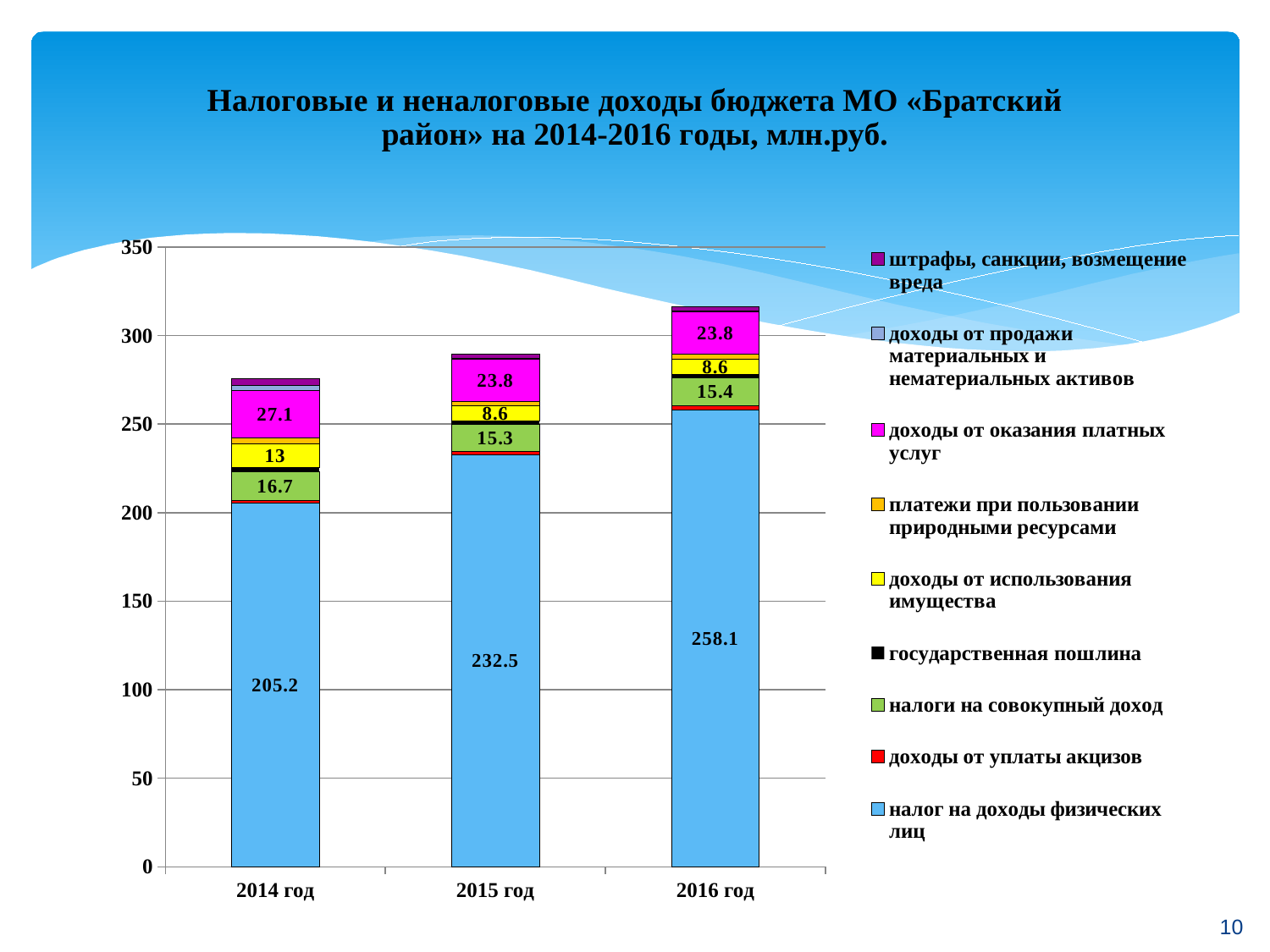
How many years (categories) are shown on the x axis? 3 What type of chart is shown on the slide? stacked bar chart What is the value of «налог на доходы физических лиц» for 2014 год? 205.2 In which year is the value of «налог на доходы физических лиц» the highest? 2016 год What is the value of «налог на доходы физических лиц» for 2016 год? 258.1 Which is larger: «доходы от оказания платных услуг» in 2014 год or in 2015 год? 2014 год What is the value of «доходы от оказания платных услуг» for 2014 год? 27.1 What is the value of «доходы от использования имущества» for 2014 год? 13 By how much did «налог на доходы физических лиц» increase from 2014 год to 2016 год? 52.9 What is the value of «налоги на совокупный доход» for 2015 год? 15.3 How many series does the legend list? 9 Does the value of «налог на доходы физических лиц» rise or fall from 2014 год to 2016 год? rise